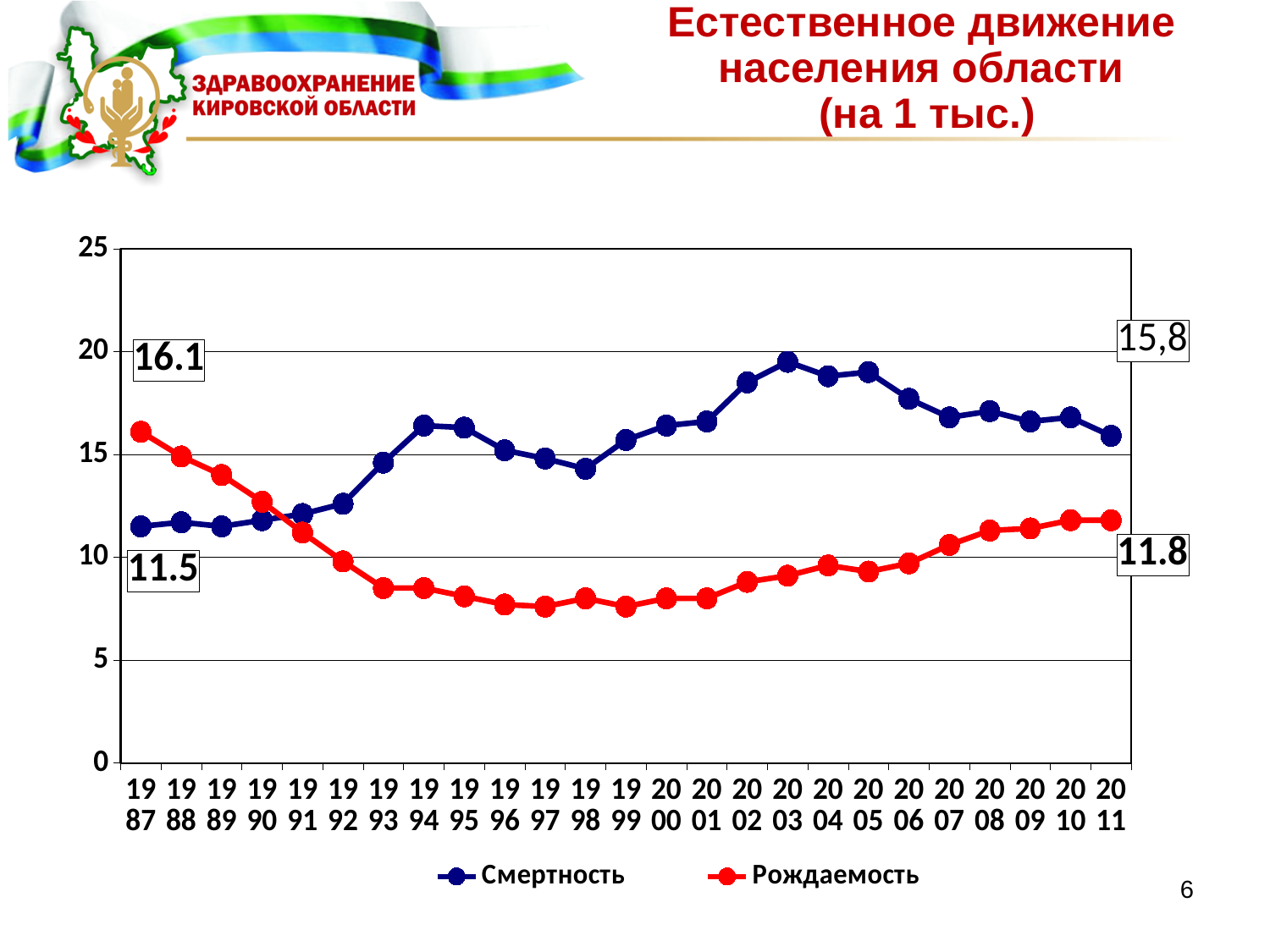
In 1987, which series has the higher value, Смертность or Рождаемость? Рождаемость How many series does the legend list? 2 What is the value of Смертность in 2011? 15,8 What kind of chart is shown on the slide? line chart In which year does Смертность reach its highest value? 2003 What is the value of Рождаемость in 1987? 16.1 Is the value of Рождаемость in 1997 greater or less than 10? less What is the value of Рождаемость in 2011? 11.8 In 2011, which series has the higher value, Смертность or Рождаемость? Смертность Does Рождаемость rise or fall from 1987 to 1997? fall What is the difference between Рождаемость and Смертность in 1987? 4.6 What is the value of Смертность in 1987? 11.5